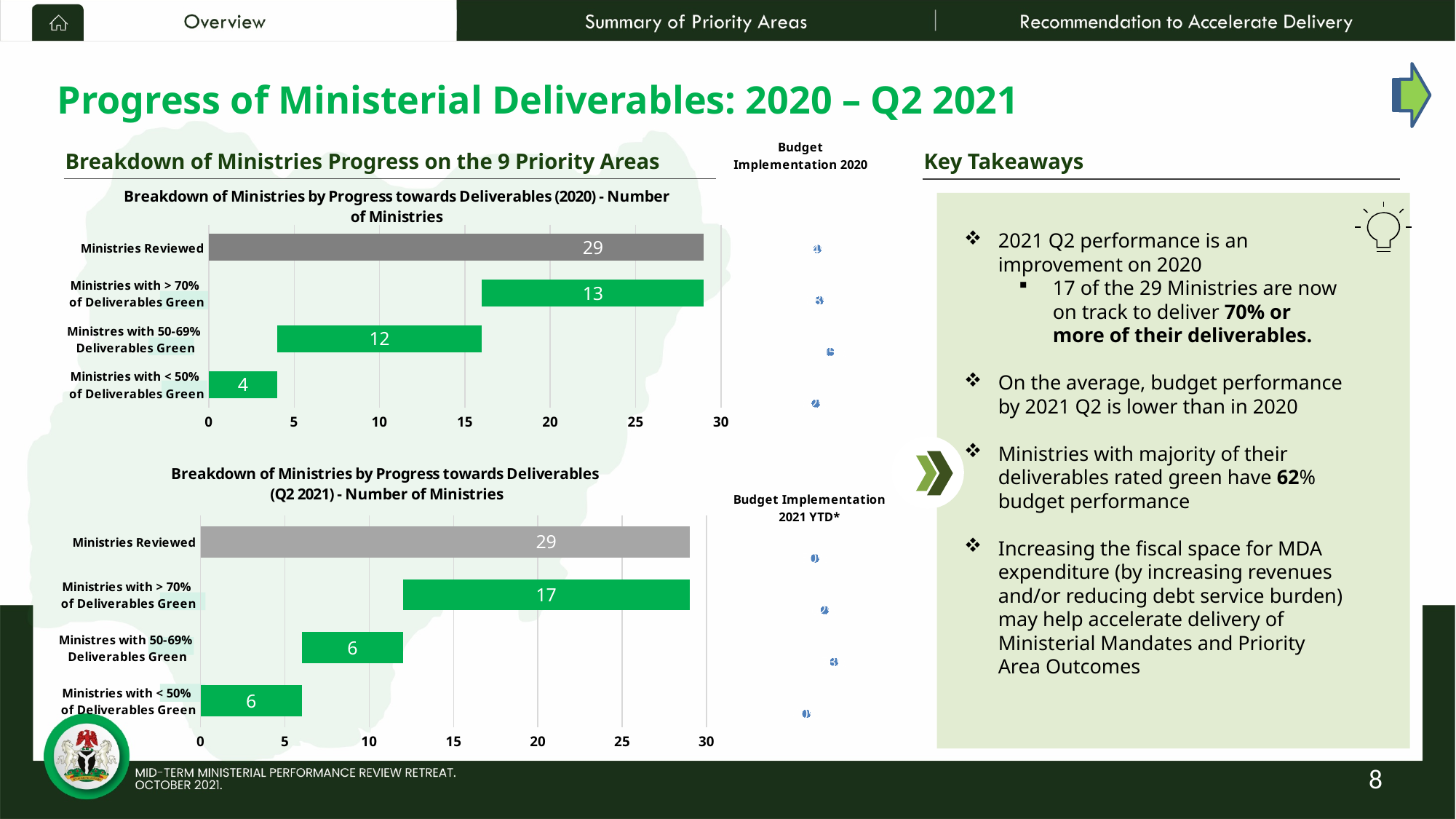
In the 2020 chart (top), which category has the smallest value? Ministries with < 50% of Deliverables Green In the Q2 2021 chart (bottom), what is the difference between Ministries Reviewed and Ministries with > 70% of deliverables green? 12 What type of chart is the 2020 chart (top)? Bar chart Which is larger: Ministries with > 70% of deliverables green in the 2020 chart or in the Q2 2021 chart? Q2 2021 chart How many categories are shown in the Q2 2021 chart (bottom)? 4 In the Q2 2021 chart (bottom), how many Ministries had 50-69% of deliverables green? 6 In the 2020 chart (top), how many Ministries had > 70% of deliverables green? 13 In the 2020 chart (top), how many Ministries were reviewed? 29 In the 2020 chart (top), what is the difference between Ministries with > 70% of deliverables green and Ministries with 50-69% deliverables green? 1 In the Q2 2021 chart (bottom), how many Ministries had > 70% of deliverables green? 17 What is the title of the bottom chart? Breakdown of Ministries by Progress towards Deliverables (Q2 2021) - Number of Ministries In the 2020 chart (top), how many Ministries had < 50% of deliverables green? 4